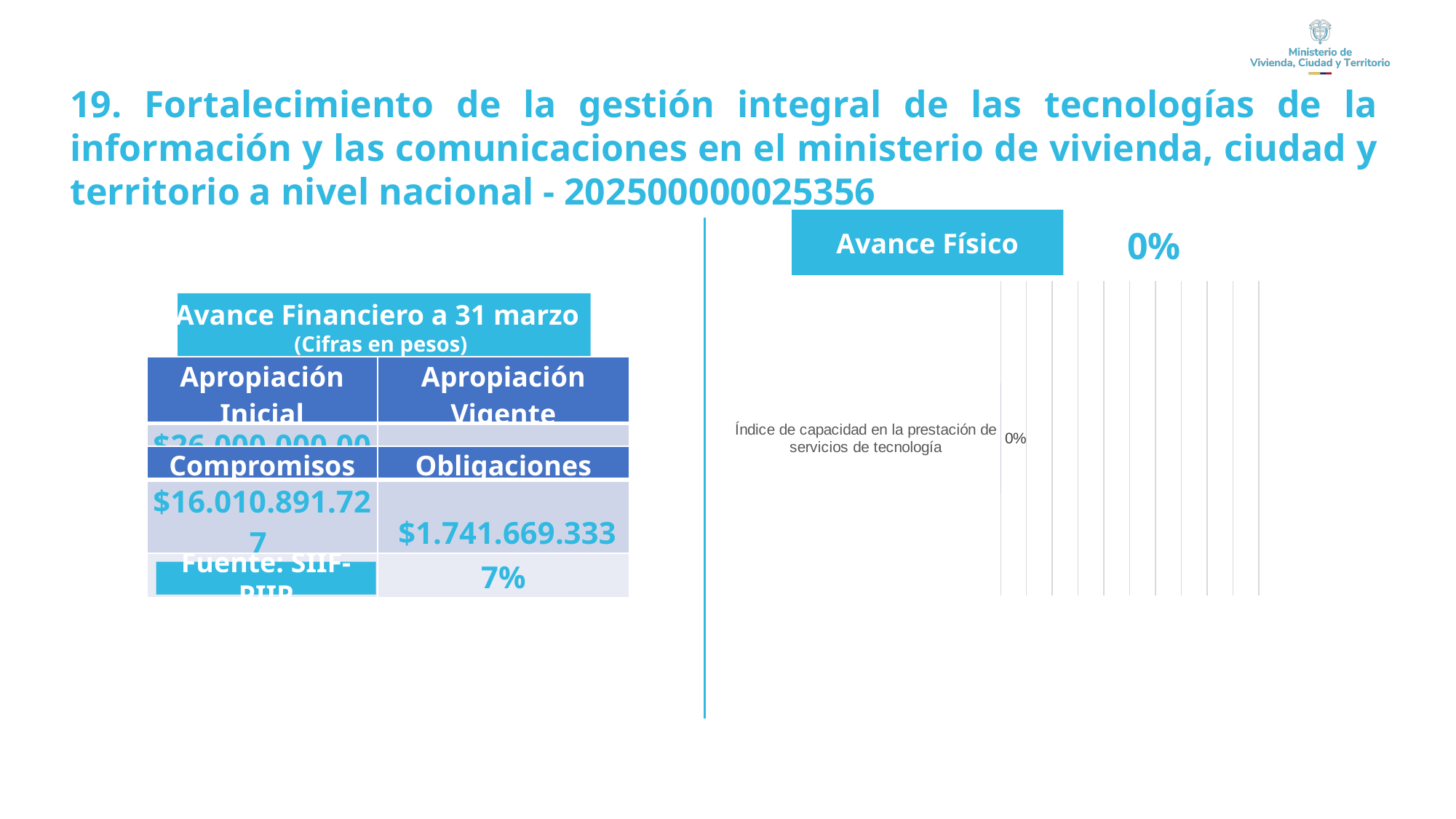
What is the value shown for "Índice de capacidad en la prestación de servicios de tecnología" in the Avance Físico chart? 0% What is the label of the single category in the Avance Físico chart? Índice de capacidad en la prestación de servicios de tecnología Is the value for "Índice de capacidad en la prestación de servicios de tecnología" in the Avance Físico chart greater than 0%? No How many categories does the Avance Físico chart show? 1 What kind of chart is the Avance Físico chart? Bar chart What heading appears above the chart on the right side of the slide? Avance Físico